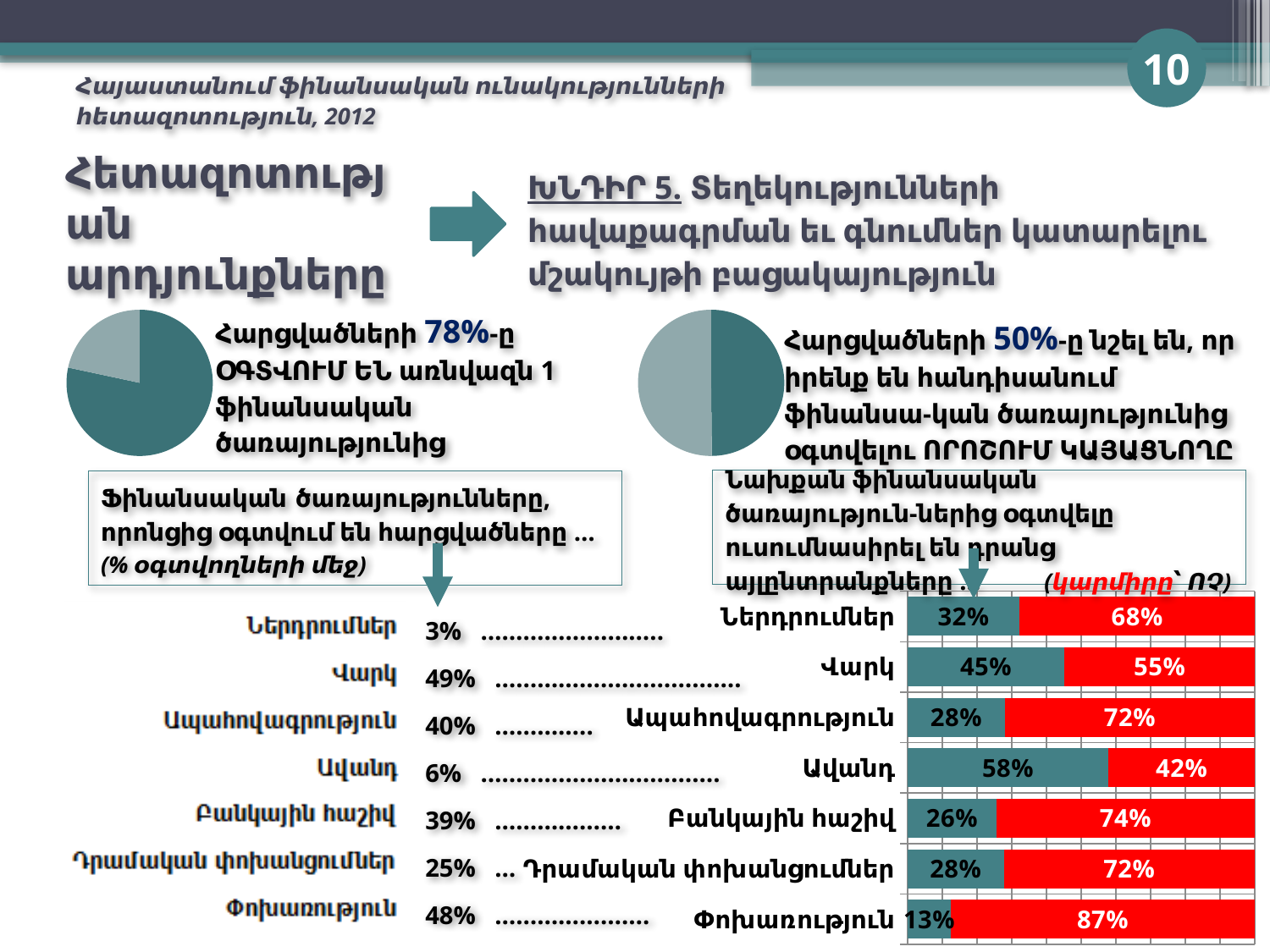
In the bottom-left chart, how many categories are listed? 7 In the bottom-right stacked bar chart, what is the teal value for Ավանդ? 58% In the bottom-right stacked bar chart, what is the total of the two segments for Ներդրումներ? 100% In the bottom-right stacked bar chart, which category has the largest red (ՈՉ) segment? Փոխառություն In the bottom-right stacked bar chart, what is the red (ՈՉ) value for Փոխառություն? 87% In the bottom-left chart, what is the difference between the values for Ապահովագրություն and Դրամական փոխանցումներ? 15% In the bottom-left chart (Ֆինանսական ծառայությունները, որոնցից օգտվում են հարցվածները), what is the value for Վարկ? 49% In the bottom-left chart, what is the value for Ներդրումներ? 3% What kind of chart is the bottom-right chart? Stacked bar chart In the bottom-right stacked bar chart, is the teal value for Վարկ or for Ապահովագրություն larger? Վարկ In the bottom-left chart, which category has the highest value? Վարկ In the bottom-left chart, which category has the lowest value? Ներդրումներ